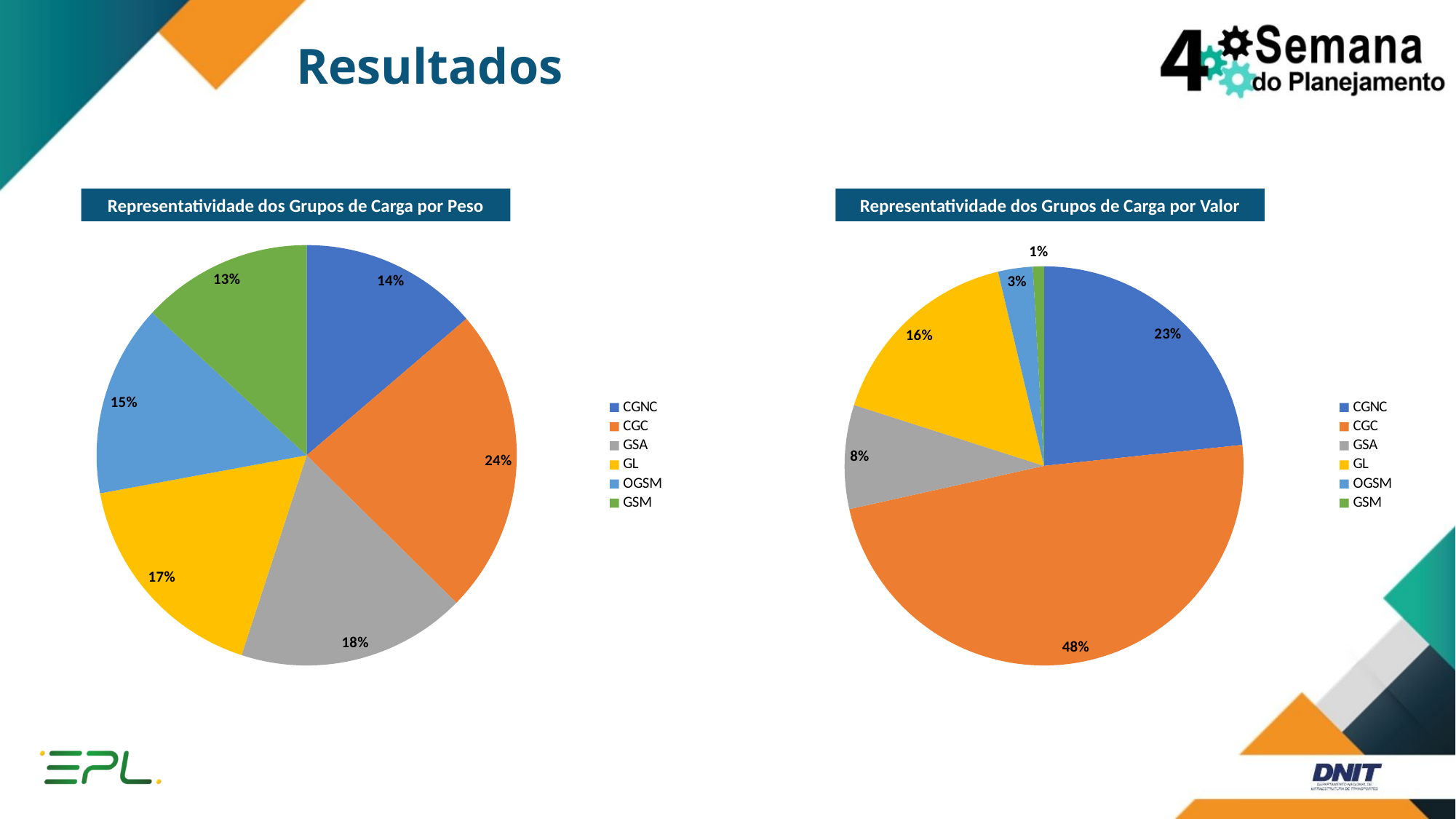
In the 'Representatividade dos Grupos de Carga por Peso' chart, which group has the largest share? CGC In the 'Representatividade dos Grupos de Carga por Valor' chart, what share does CGC have? 48% In the 'Representatividade dos Grupos de Carga por Peso' chart, what share does CGC have? 24% In the 'Representatividade dos Grupos de Carga por Valor' chart, which group has the smallest share? GSM In the 'Representatividade dos Grupos de Carga por Valor' chart, what is the difference between the shares of CGC and CGNC? 25% What type of chart is 'Representatividade dos Grupos de Carga por Valor'? Pie chart In the 'Representatividade dos Grupos de Carga por Valor' chart, what share does GSA have? 8% In the 'Representatividade dos Grupos de Carga por Peso' chart, what is the difference between the shares of GSA and OGSM? 3% In the 'Representatividade dos Grupos de Carga por Valor' chart, which is larger, the share of CGNC or the share of GL? CGNC How many groups are shown in the 'Representatividade dos Grupos de Carga por Peso' chart? 6 In the 'Representatividade dos Grupos de Carga por Peso' chart, what share does GSM have? 13% In the 'Representatividade dos Grupos de Carga por Peso' chart, which group has the smallest share? GSM